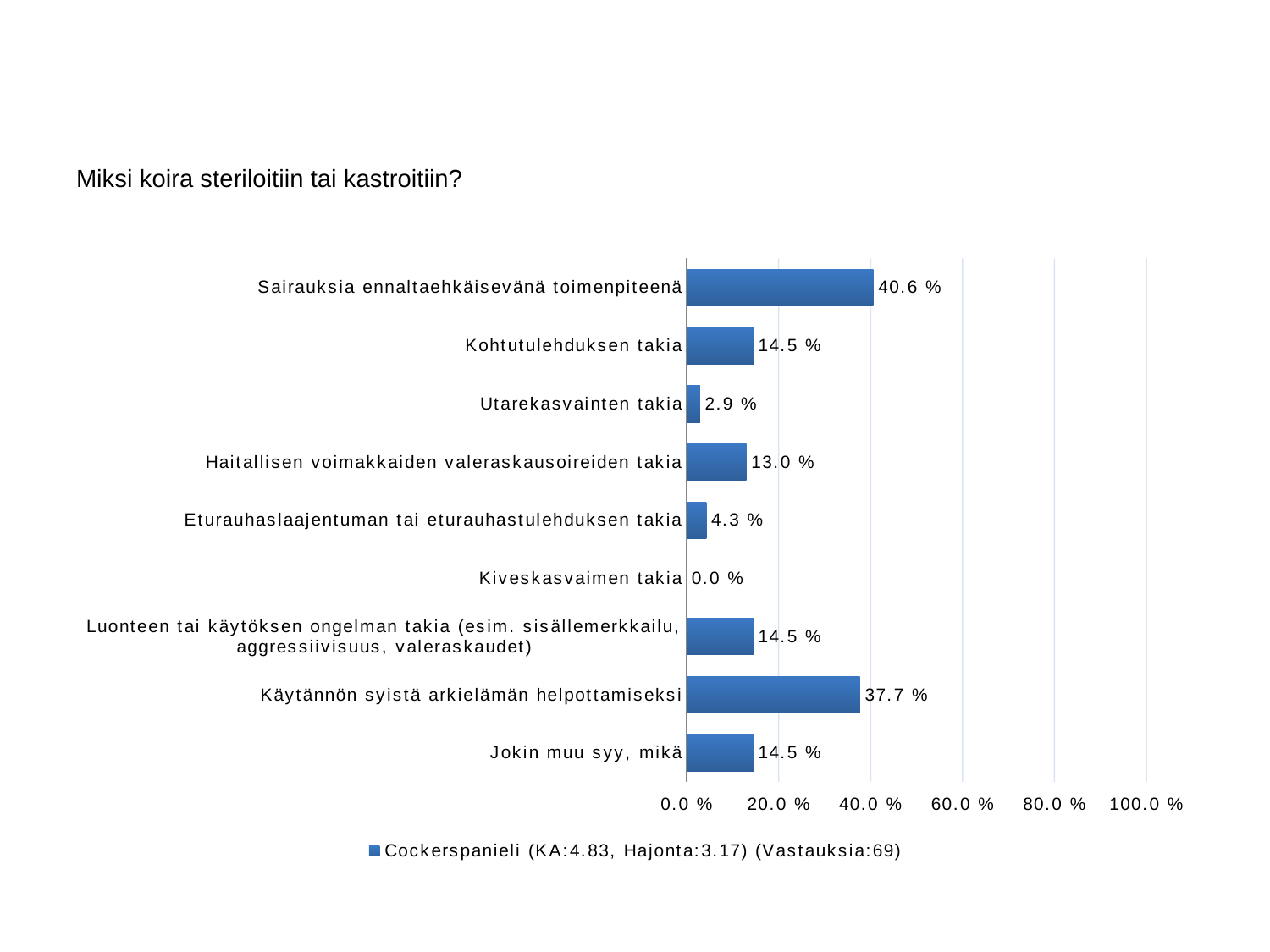
How many categories are shown in the chart? 9 What is the value for "Kiveskasvaimen takia"? 0.0 % Is the value for "Sairauksia ennaltaehkäisevänä toimenpiteenä" greater or less than 20.0 %? greater Which is larger, the value for "Haitallisen voimakkaiden valeraskausoireiden takia" or the value for "Kohtutulehduksen takia"? Kohtutulehduksen takia What is the value for "Käytännön syistä arkielämän helpottamiseksi"? 37.7 % What is the value for "Sairauksia ennaltaehkäisevänä toimenpiteenä"? 40.6 % What kind of chart is shown on the slide? Bar chart What is the value for "Utarekasvainten takia"? 2.9 % Which category has the lowest value? Kiveskasvaimen takia What is the difference between the values for "Sairauksia ennaltaehkäisevänä toimenpiteenä" and "Käytännön syistä arkielämän helpottamiseksi"? 2.9 % What is the title of the chart? Miksi koira steriloitiin tai kastroitiin? Which category has the highest value? Sairauksia ennaltaehkäisevänä toimenpiteenä